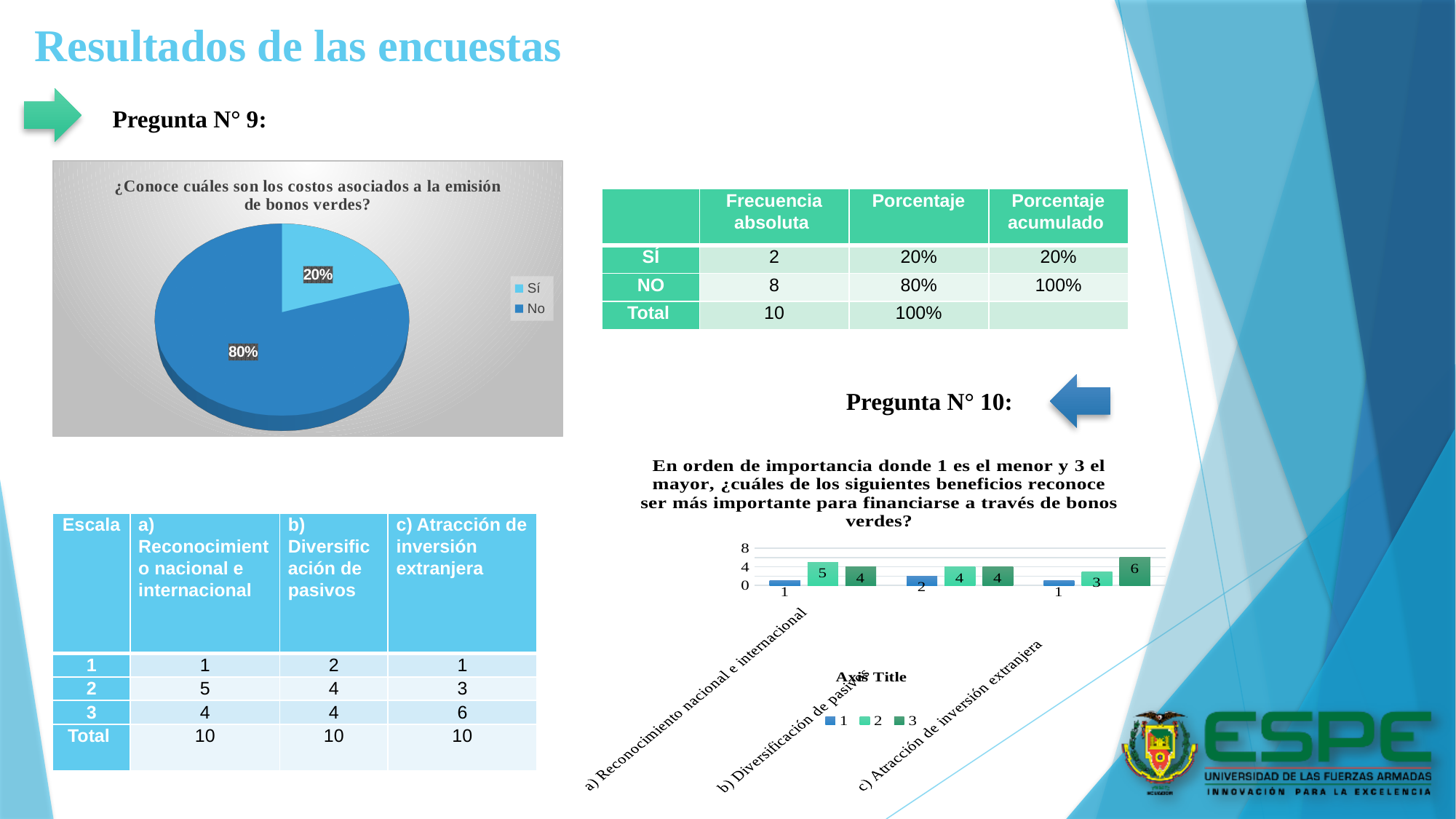
In the Pregunta N° 10 bar chart, what is the value of series 1 for "b) Diversificación de pasivos"? 2 In the Pregunta N° 10 bar chart, what is the value of series 2 for "a) Reconocimiento nacional e internacional"? 5 How many categories are shown on the x axis of the Pregunta N° 10 bar chart? 3 How many series does the legend of the Pregunta N° 10 chart list? 3 In the Pregunta N° 10 bar chart, which category has the highest value for series 3? c) Atracción de inversión extranjera What type of chart is used for Pregunta N° 10? Bar chart What type of chart is used for Pregunta N° 9? Pie chart In the pie chart for Pregunta N° 9, what share of respondents answered "Sí"? 20% In the Pregunta N° 10 bar chart, what is the difference between series 3 and series 2 for "c) Atracción de inversión extranjera"? 3 In the pie chart for Pregunta N° 9, which answer has the larger slice, Sí or No? No In the Pregunta N° 10 bar chart, what is the value of series 3 for "c) Atracción de inversión extranjera"? 6 In the pie chart for Pregunta N° 9, what share of respondents answered "No"? 80%